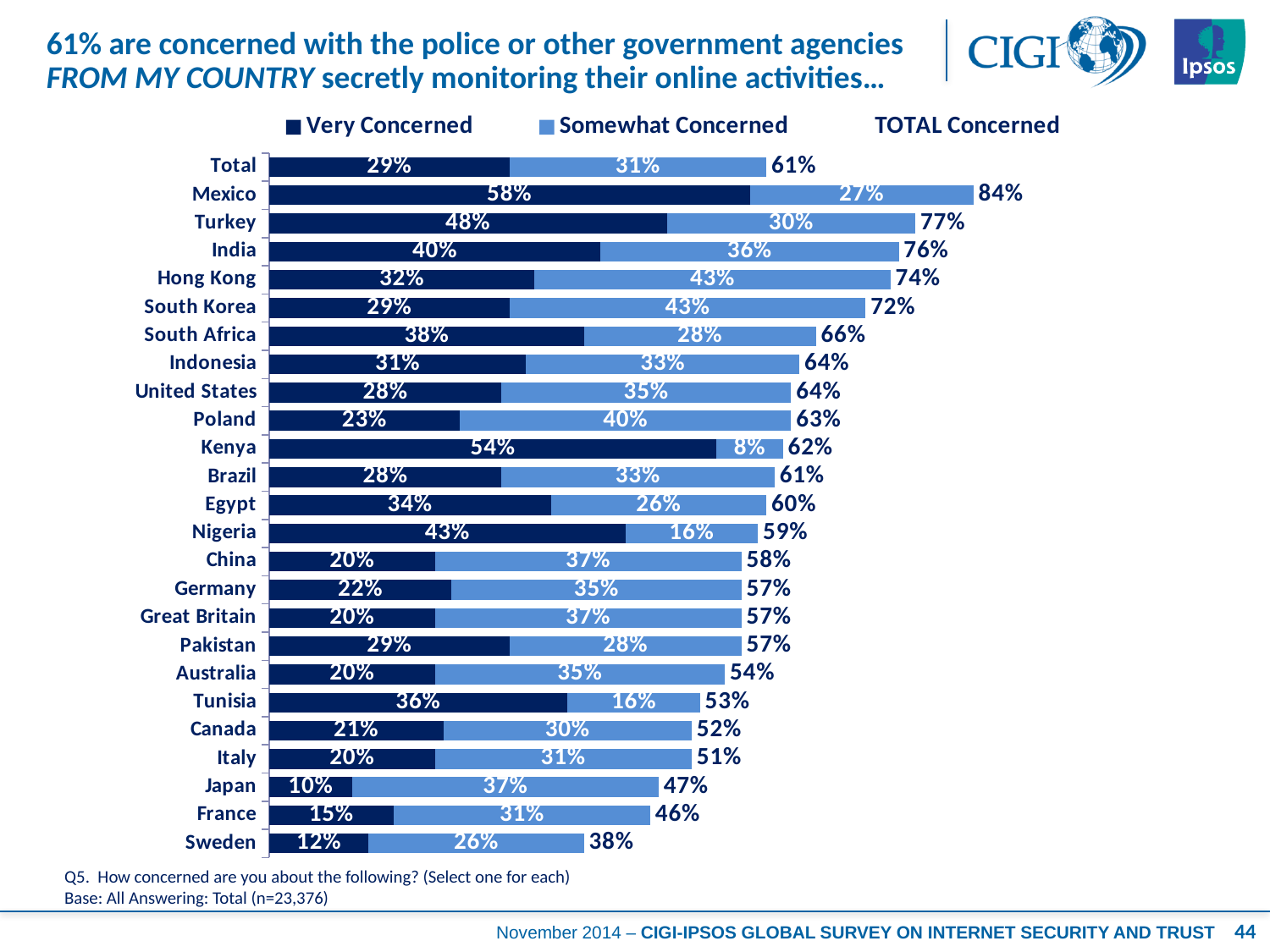
Which country has the lowest Very Concerned value? Japan What is the difference between the TOTAL Concerned values for Mexico and Sweden? 46 percentage points Which country has the lowest TOTAL Concerned value? Sweden What is the Very Concerned value for Mexico? 58% Which country has the highest TOTAL Concerned value? Mexico What is the Somewhat Concerned value for Hong Kong? 43% What is the TOTAL Concerned value for Japan? 47% What is the total of the stacked bar for Kenya? 62% Which has a larger Very Concerned value, Kenya or Turkey? Kenya What kind of chart is shown on the slide? Stacked bar chart How many coloured series does the legend list? 2 How many countries are shown in the chart, not counting the Total row? 24